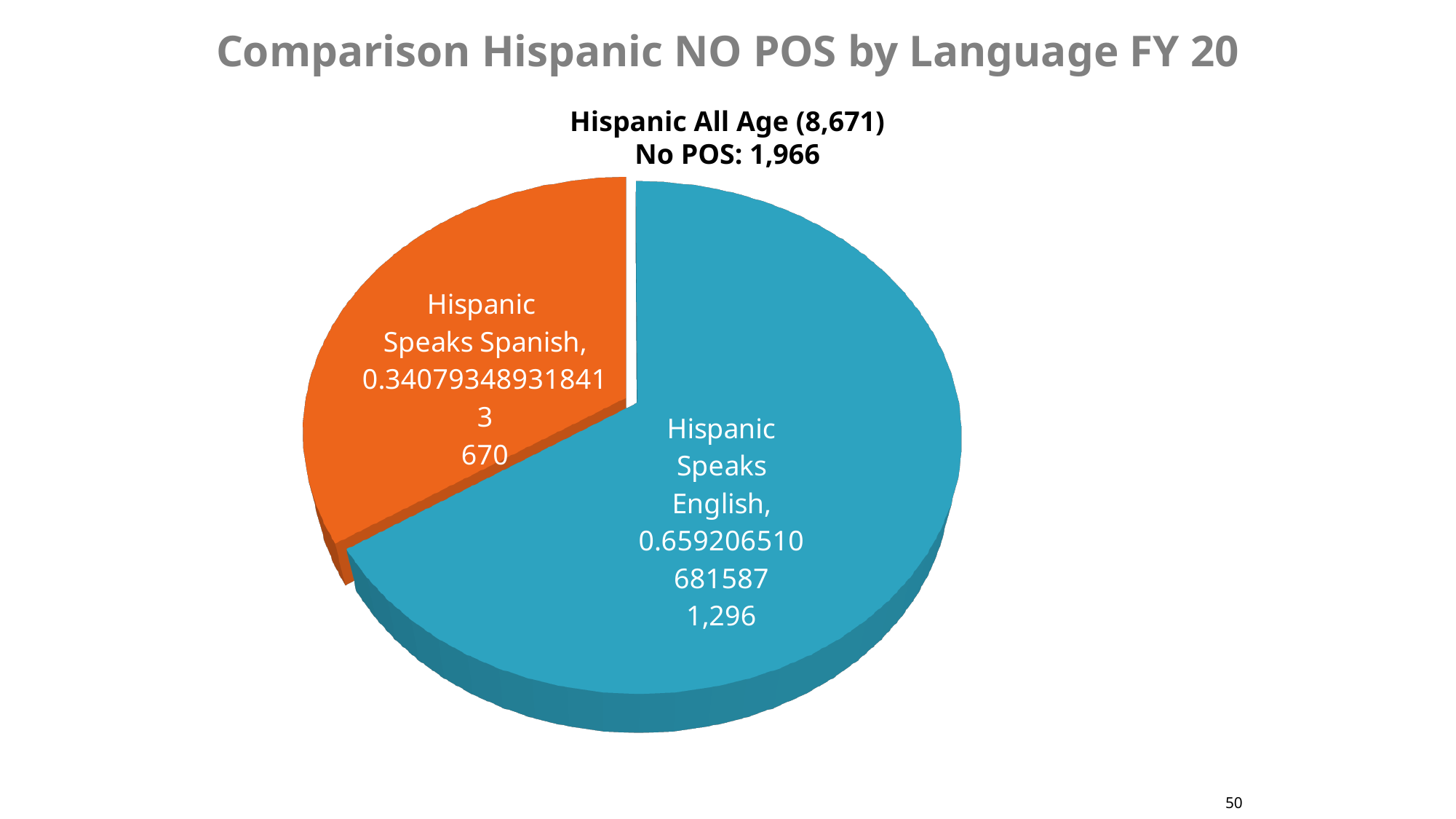
How many slices does the pie chart have? 2 What is the value for Hispanic Speaks English? 1,296 Which slice is the smallest? Hispanic Speaks Spanish What share of the pie does Hispanic Speaks English represent, as printed on the slide? 0.659206510681587 What share of the pie does Hispanic Speaks Spanish represent, as printed on the slide? 0.340793489318413 What is the difference between the Hispanic Speaks English value and the Hispanic Speaks Spanish value? 626 What is the value for Hispanic Speaks Spanish? 670 What kind of chart is shown on the slide? pie chart What is the total of the two slices in the pie chart? 1,966 What is the title of the pie chart? Hispanic All Age (8,671) No POS: 1,966 Which slice is the largest? Hispanic Speaks English Which is larger, Hispanic Speaks Spanish or Hispanic Speaks English? Hispanic Speaks English